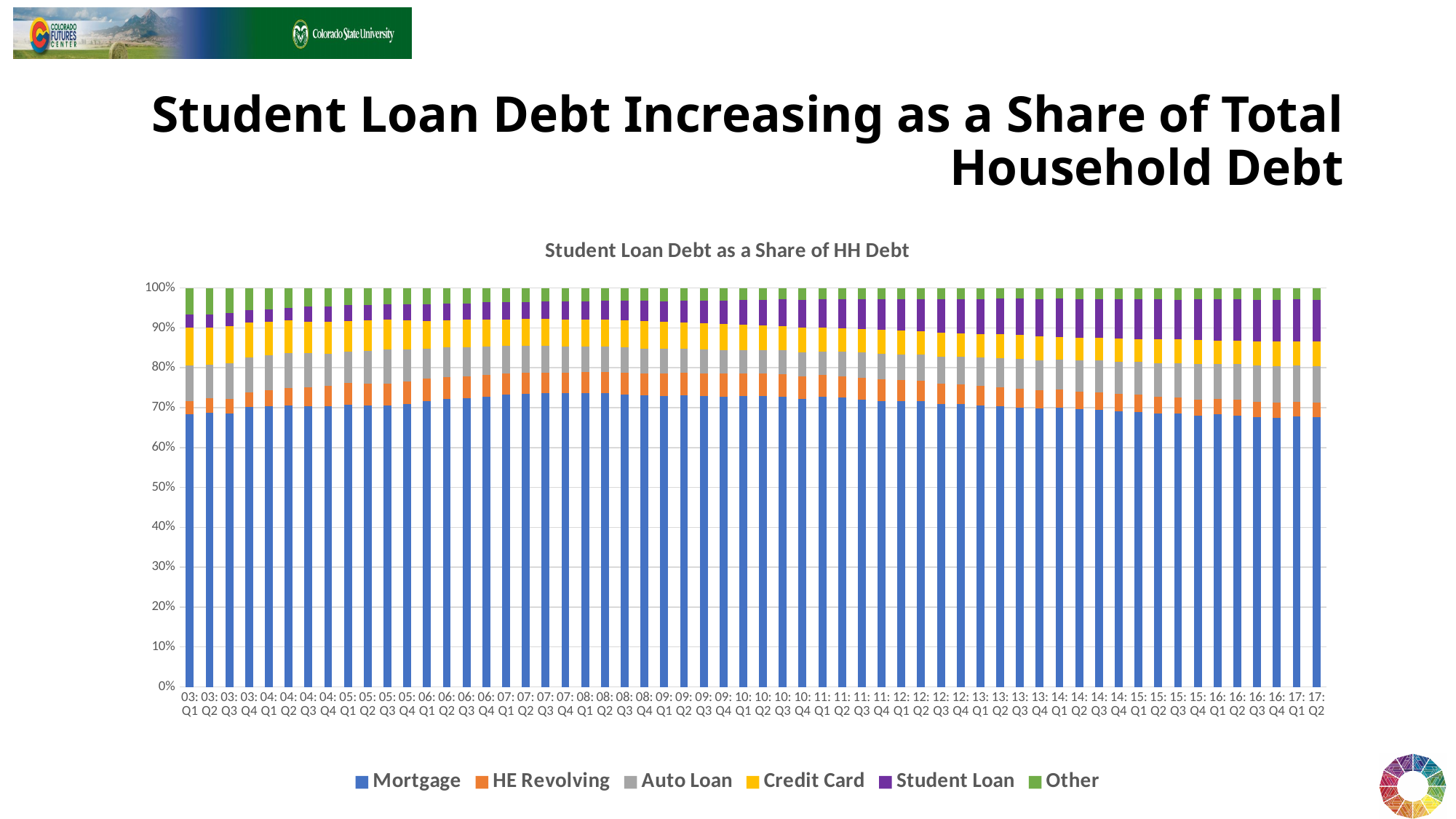
Which colour represents the Student Loan series in the legend? Purple What is the title of the chart? Student Loan Debt as a Share of HH Debt How many series does the legend list? 6 What kind of chart is shown on the slide? Stacked bar chart Is the Mortgage share for 17: Q2 greater or less than 70%? less What does each stacked bar total? 100% Is the Mortgage share for 03: Q1 greater or less than 60%? greater How many quarterly bars are plotted in the chart? 58 Which series occupies the largest share of each stacked bar? Mortgage Does the Student Loan share of household debt rise or fall from 03: Q1 to 17: Q2? rise Is the Mortgage share for 07: Q3 greater or less than 70%? greater Which quarter has the larger Mortgage share, 07: Q3 or 17: Q2? 07: Q3